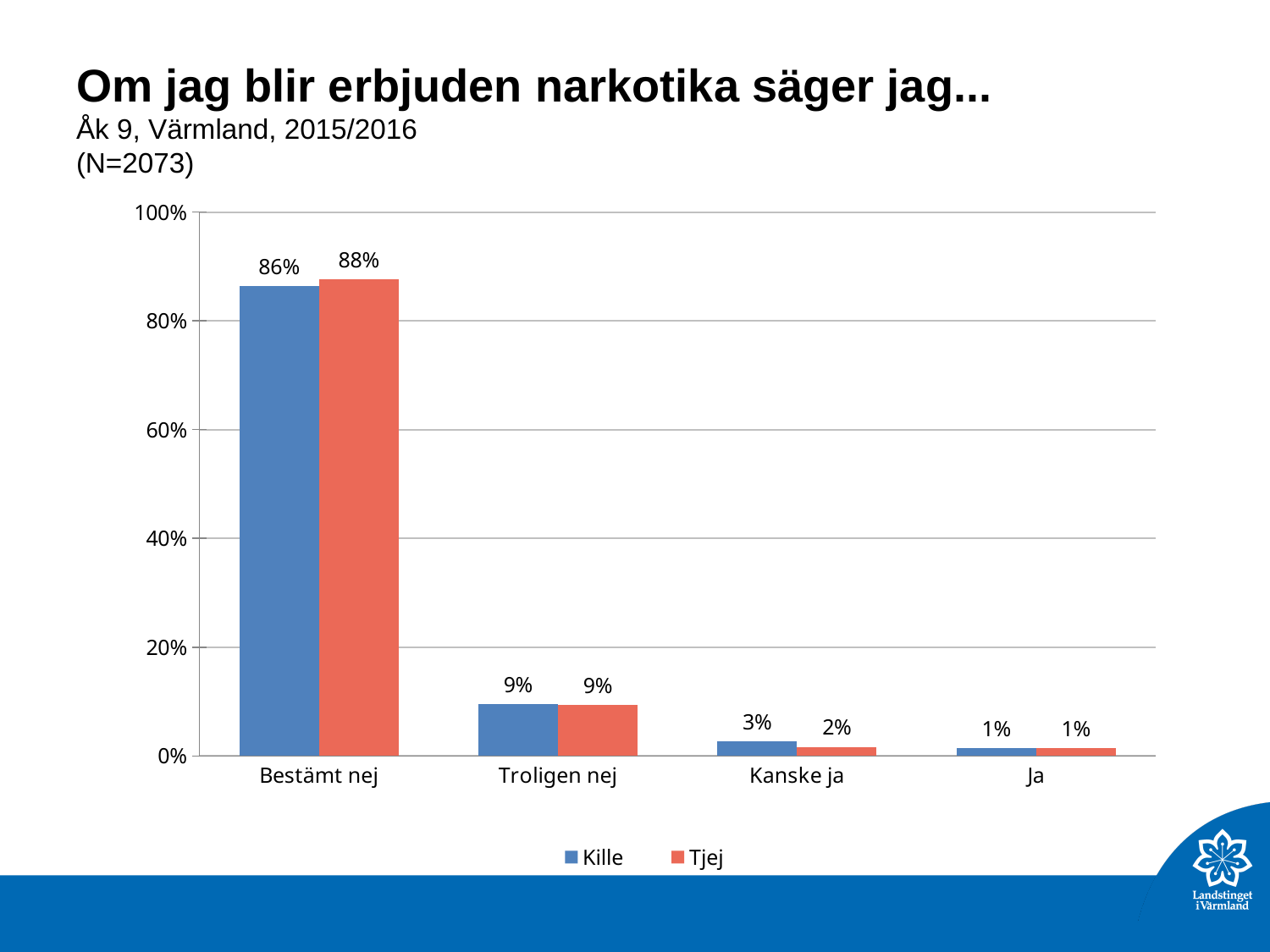
What is the difference between the Tjej and Kille values in the Bestämt nej category? 2% What kind of chart is shown on the slide? Bar chart How many categories are shown on the x axis? 4 What is the value for Tjej in the Troligen nej category? 9% What is the value for Kille in the Kanske ja category? 3% Which category has the highest value for Tjej? Bestämt nej Is the value for Kille in the Bestämt nej category greater or less than 80%? greater Which category has the lowest value for Kille? Ja Which is larger in the Kanske ja category, Kille or Tjej? Kille What is the value for Tjej in the Bestämt nej category? 88% What is the value for Kille in the Bestämt nej category? 86% How many series does the legend list? 2